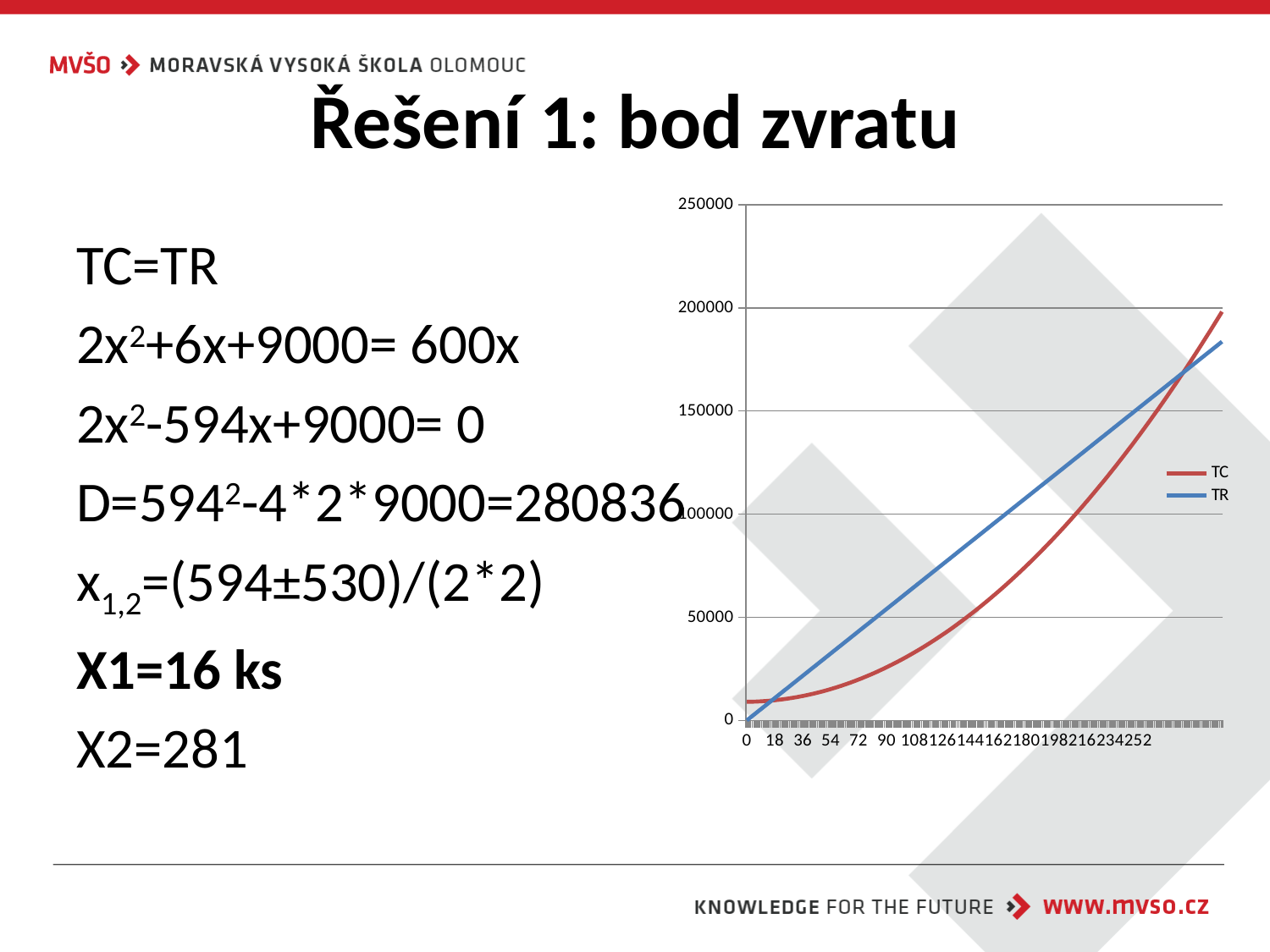
Is the value of TR at x = 126 greater or less than 50000? greater What kind of chart is shown on the slide? line chart What colour is the TC line in the chart? red What are the two series named in the chart legend? TC and TR How many series does the chart legend list? 2 Is the value of TC at x = 126 greater or less than 50000? less At x = 90, which series has the higher value, TC or TR? TR Does the TC line rise or fall as x increases along the x axis? rises What is the highest value shown on the chart's y axis? 250000 Does the TR line rise or fall as x increases along the x axis? rises Is the value of TC at x = 234 greater or less than 100000? greater At x = 0, which series has the higher value, TC or TR? TC